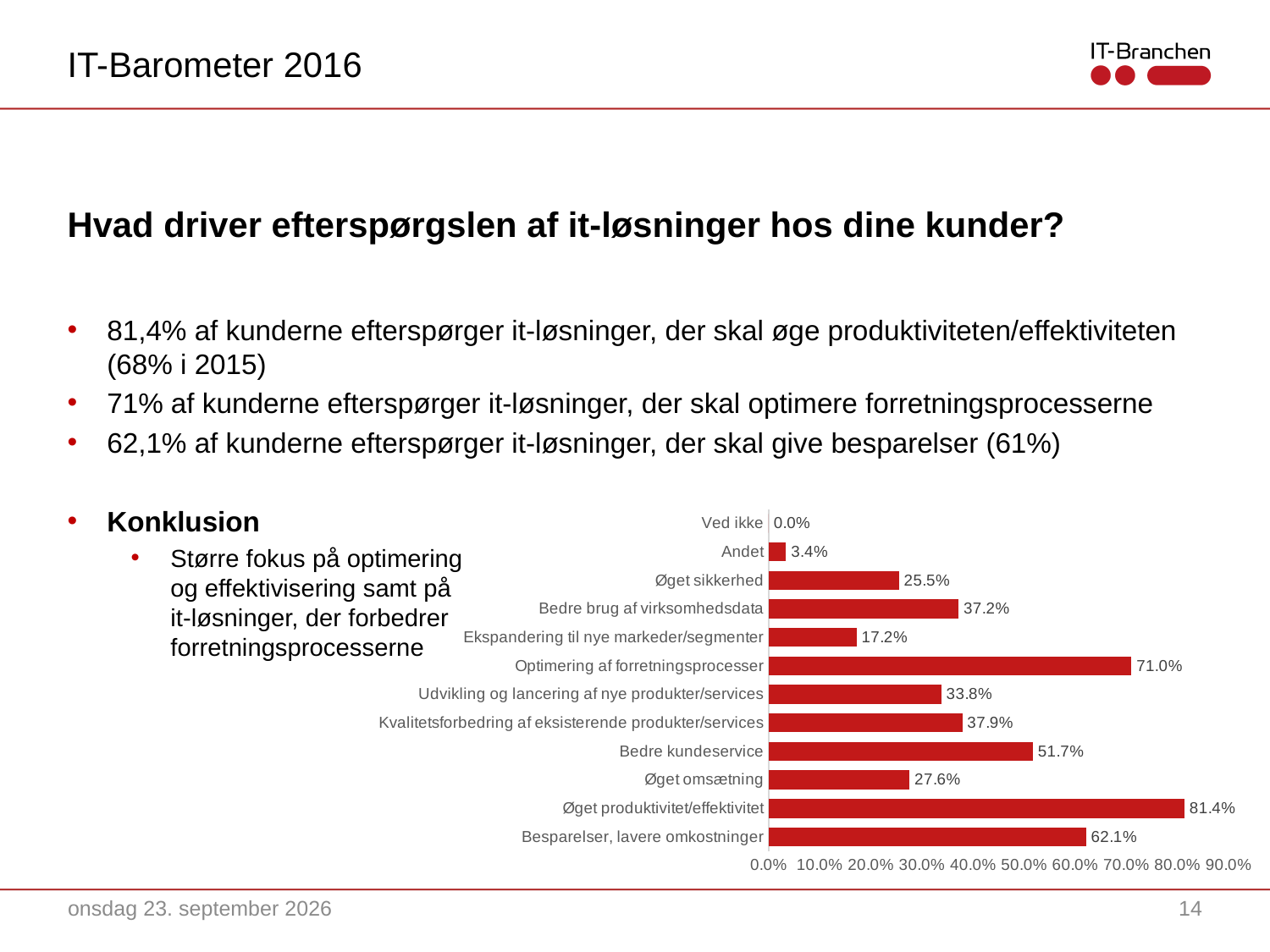
Is the value for Øget sikkerhed greater or less than 30.0%? less How many categories are shown in the chart? 12 Which category has the lowest value? Ved ikke What is the value for Bedre kundeservice? 51.7% What is the difference between Øget produktivitet/effektivitet and Optimering af forretningsprocesser? 10.4% What is the value for Optimering af forretningsprocesser? 71.0% Which category has the highest value? Øget produktivitet/effektivitet What is the value for Ekspandering til nye markeder/segmenter? 17.2% What kind of chart is shown on the slide? bar chart What is the value for Øget produktivitet/effektivitet? 81.4% Which is larger, Besparelser, lavere omkostninger or Bedre kundeservice? Besparelser, lavere omkostninger What is the difference between Kvalitetsforbedring af eksisterende produkter/services and Bedre brug af virksomhedsdata? 0.7%